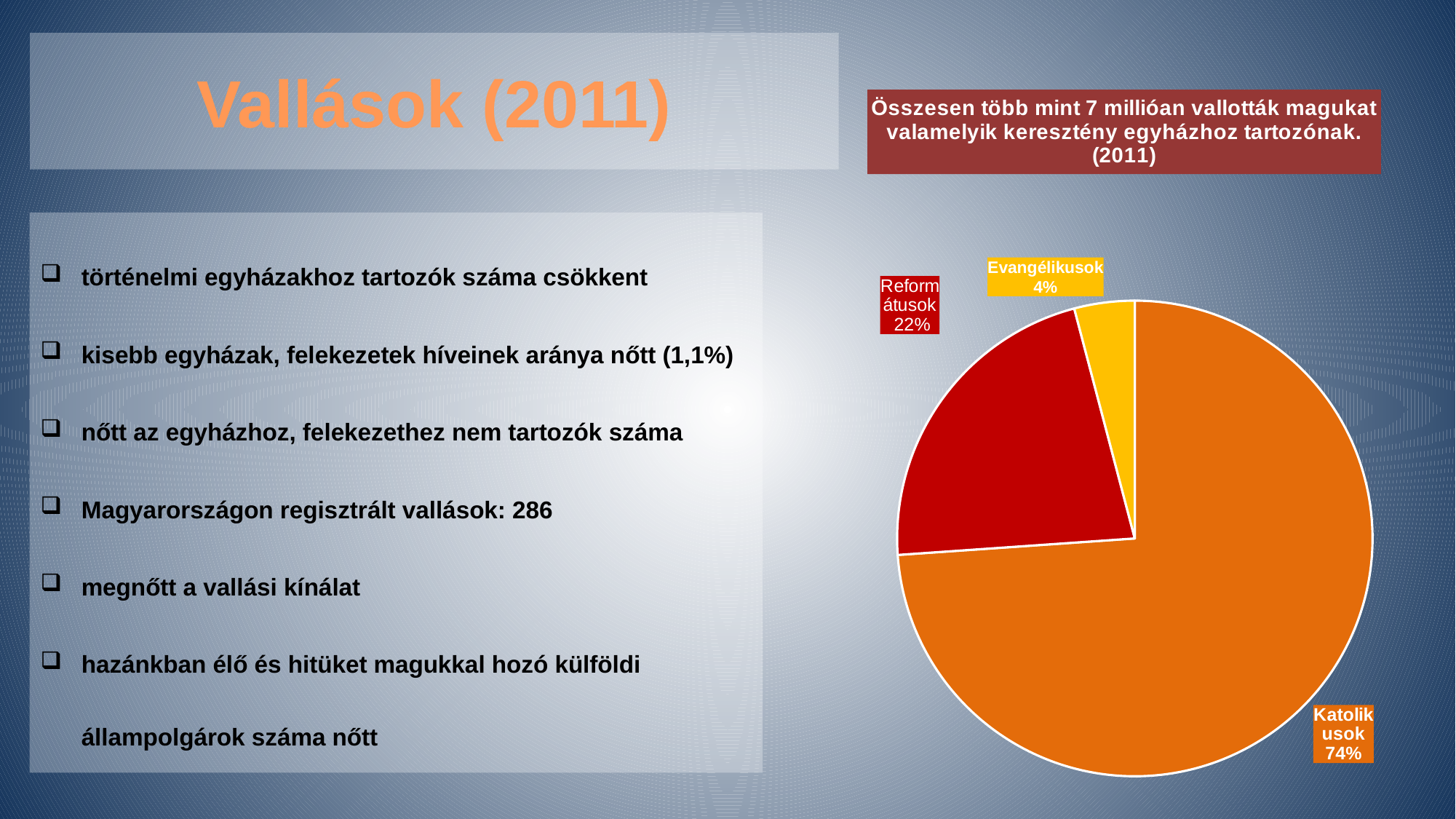
What kind of chart is shown on the slide? pie chart Which slice of the pie chart is the largest? Katolikusok Which slice of the pie chart is the smallest? Evangélikusok What share of the pie is Katolikusok? 74% What colour is the Katolikusok slice of the pie chart? orange What is the difference in percentage points between the Reformátusok and Evangélikusok slices? 18 How many slices does the pie chart have? 3 What share of the pie is Reformátusok? 22% Which is larger, the Reformátusok slice or the Evangélikusok slice? Reformátusok What colour is the Evangélikusok slice of the pie chart? yellow What is the difference in percentage points between the Katolikusok and Reformátusok slices? 52 What share of the pie is Evangélikusok? 4%